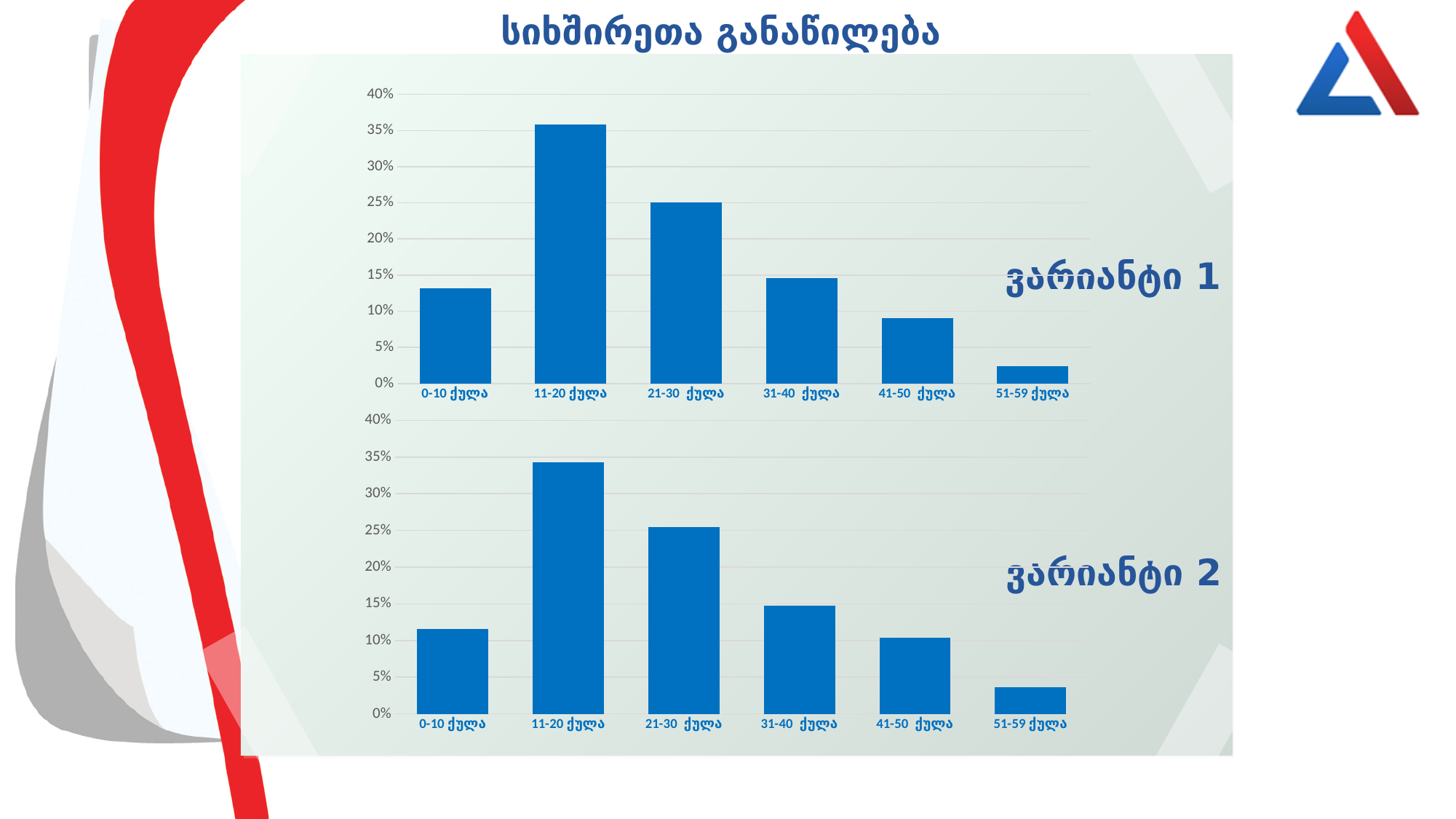
How many categories are shown on the x axis of the bottom chart (ვარიანტი 2)? 6 In the bottom chart (ვარიანტი 2), which category has the highest value? 11-20 ქულა In the top chart (ვარიანტი 1), which category has the lowest value? 51-59 ქულა In the top chart (ვარიანტი 1), which is larger: the value for 21-30 ქულა or the value for 31-40 ქულა? 21-30 ქულა In the bottom chart (ვარიანტი 2), do the values rise or fall from 11-20 ქულა to 51-59 ქულა? fall What kind of chart is the top chart (ვარიანტი 1)? bar chart In the top chart (ვარიანტი 1), is the value for 11-20 ქულა greater or less than 30%? greater In the bottom chart (ვარიანტი 2), is the value for 51-59 ქულა greater or less than 5%? less In the top chart (ვარიანტი 1), which category has the highest value? 11-20 ქულა In the top chart (ვარიანტი 1), is the value for 41-50 ქულა greater or less than 10%? less In the bottom chart (ვარიანტი 2), which category has the lowest value? 51-59 ქულა